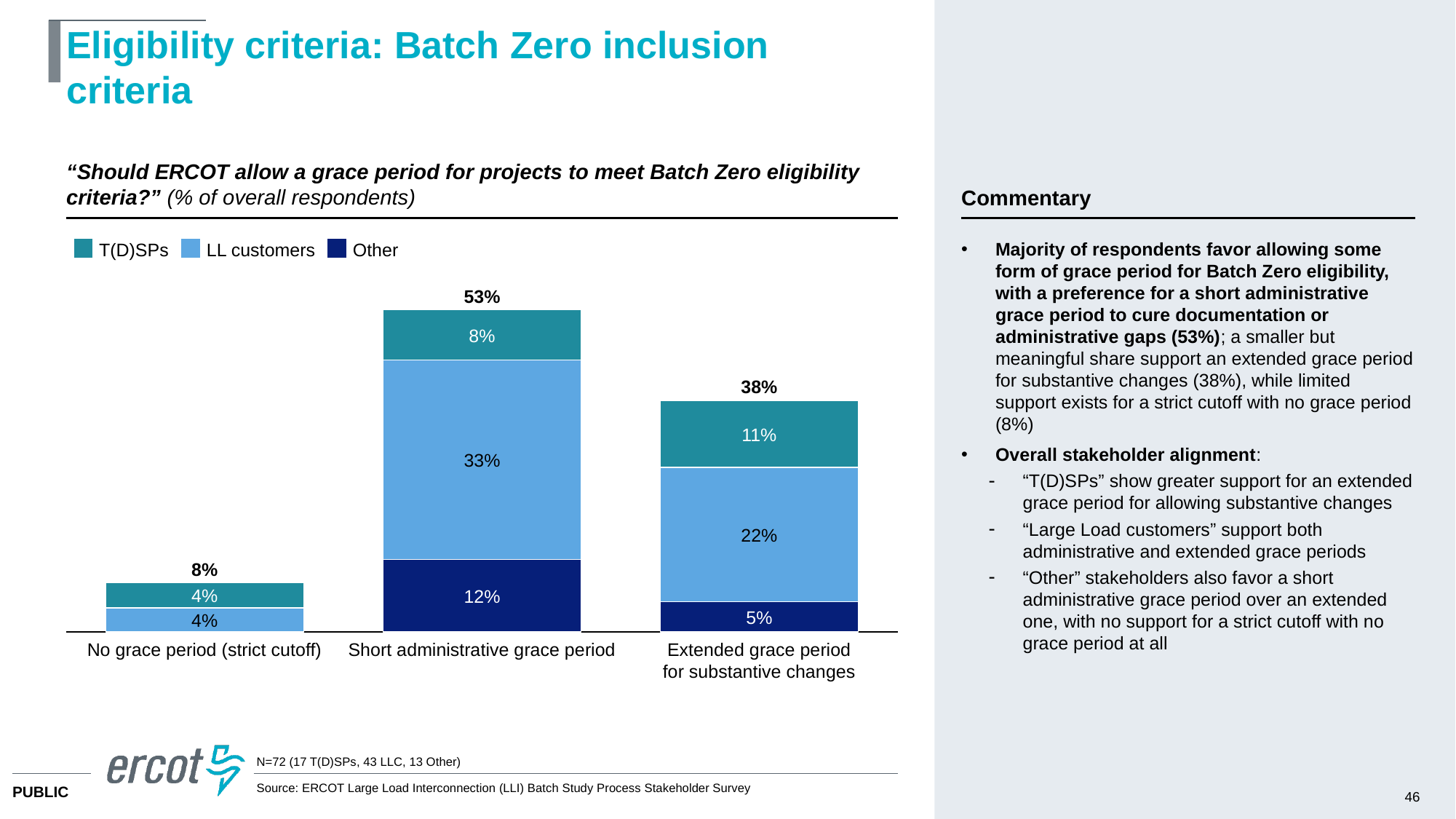
What is the LL customers value for Extended grace period for substantive changes? 22% How many series does the legend list? 3 Which category has the highest total? Short administrative grace period What is the T(D)SPs value for Short administrative grace period? 8% Which category has the lowest total? No grace period (strict cutoff) What is the Other value for Short administrative grace period? 12% What kind of chart is shown? Stacked bar chart What is the T(D)SPs value for No grace period (strict cutoff)? 4% What is the difference between the totals for Short administrative grace period and Extended grace period for substantive changes? 15% Which is larger: the T(D)SPs value for Extended grace period for substantive changes or the T(D)SPs value for Short administrative grace period? Extended grace period for substantive changes How many categories are shown on the x axis? 3 What is the total for the Short administrative grace period bar? 53%